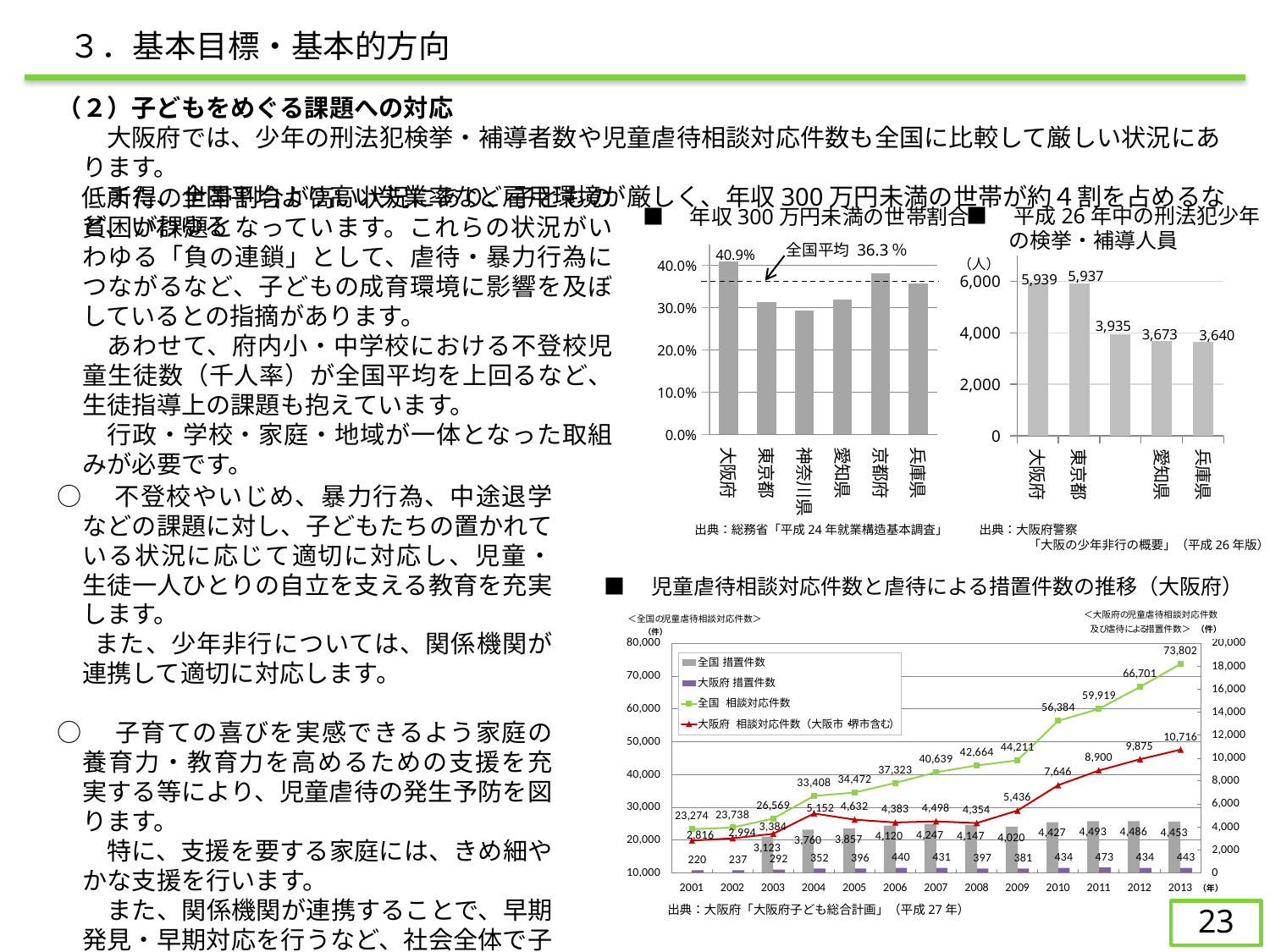
In the chart titled 平成26年中の刑法犯少年の検挙・補導人員, what is the value for 東京都? 5,937 In the chart titled 平成26年中の刑法犯少年の検挙・補導人員, what is the difference between 大阪府 and 兵庫県? 2,299 In the chart titled 年収300万円未満の世帯割合, how many prefectures are shown? 6 In the chart titled 児童虐待相談対応件数と虐待による措置件数の推移（大阪府）, what is the 全国 相談対応件数 value for 2013? 73,802 In the chart titled 児童虐待相談対応件数と虐待による措置件数の推移（大阪府）, what is the difference in 全国 相談対応件数 between 2013 and 2012? 7,101 What kind of chart is the one titled 平成26年中の刑法犯少年の検挙・補導人員? Bar chart In the chart titled 年収300万円未満の世帯割合, what is the value for 大阪府? 40.9% In the chart titled 児童虐待相談対応件数と虐待による措置件数の推移（大阪府）, how many series does the legend list? 4 In the chart titled 年収300万円未満の世帯割合, which prefecture has the highest value? 大阪府 In the chart titled 年収300万円未満の世帯割合, is the value for 京都府 greater or less than 30.0%? greater In the chart titled 年収300万円未満の世帯割合, what national average (全国平均) is shown? 36.3% In the chart titled 児童虐待相談対応件数と虐待による措置件数の推移（大阪府）, does the 全国 相談対応件数 series rise or fall from 2001 to 2013? Rise